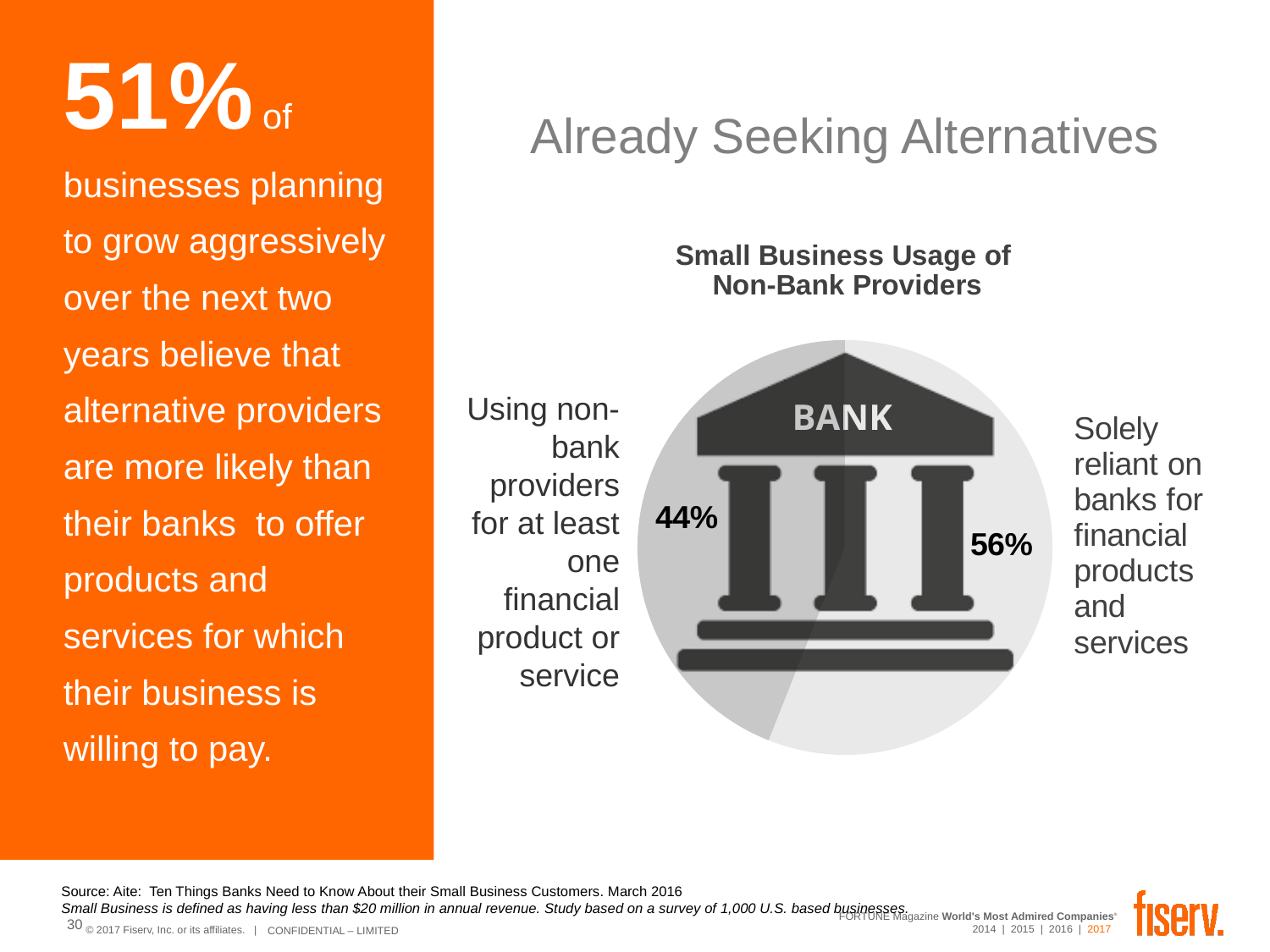
Which slice of the pie chart is larger: using non-bank providers or solely reliant on banks? Solely reliant on banks What percentage of small businesses are solely reliant on banks for financial products and services? 56% How many slices does the pie chart have? 2 Which category has the smallest share in the pie chart? Using non-bank providers for at least one financial product or service What percentage of small businesses are using non-bank providers for at least one financial product or service? 44% Is the share of small businesses solely reliant on banks greater or less than 50%? greater What is the total of the two slices shown in the pie chart? 100% What is the title of the chart on the slide? Small Business Usage of Non-Bank Providers What kind of chart is shown under the title "Small Business Usage of Non-Bank Providers"? pie chart What image is placed in the centre of the pie chart? A bank building What is the difference in percentage points between the solely-reliant-on-banks slice and the using-non-bank-providers slice? 12